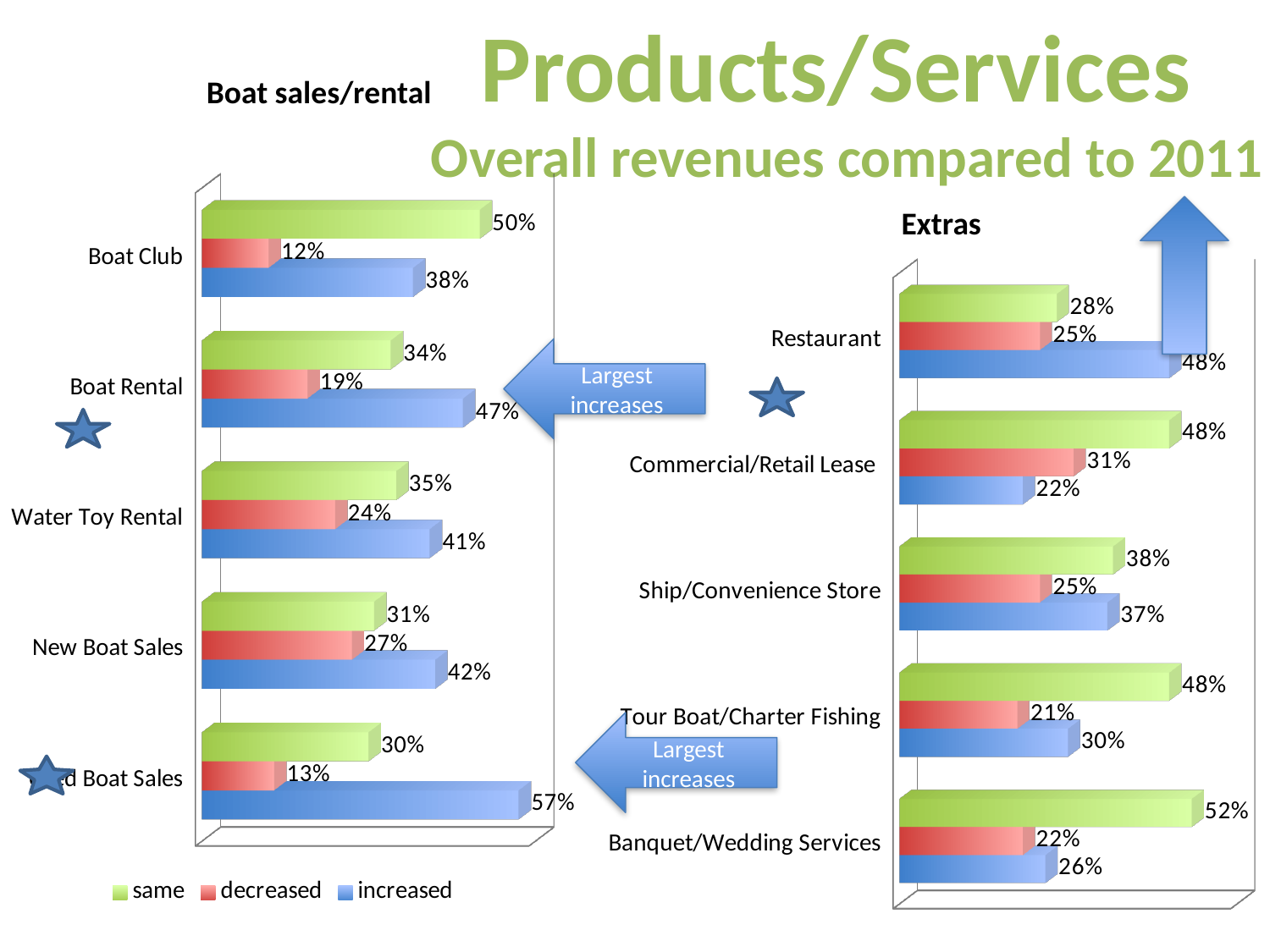
In the Extras chart, which category has the lowest 'increased' value? Commercial/Retail Lease In the Boat sales/rental chart, what is the 'increased' value for Boat Rental? 47% In the Boat sales/rental chart, what is the 'same' value for Boat Club? 50% How many series does the legend of the Boat sales/rental chart list? 3 In the Extras chart, which category has the highest 'same' value? Banquet/Wedding Services In the Extras chart, which is larger for Tour Boat/Charter Fishing: the 'same' value or the 'increased' value? same In the Extras chart, what is the 'increased' value for Restaurant? 48% In the Extras chart, what is the 'decreased' value for Commercial/Retail Lease? 31% What kind of chart is the Extras chart? bar chart In the Boat sales/rental chart, which category has the lowest 'decreased' value? Boat Club In the Boat sales/rental chart, what is the difference between the 'increased' and 'decreased' values for New Boat Sales? 15% How many categories are shown in the Extras chart? 5